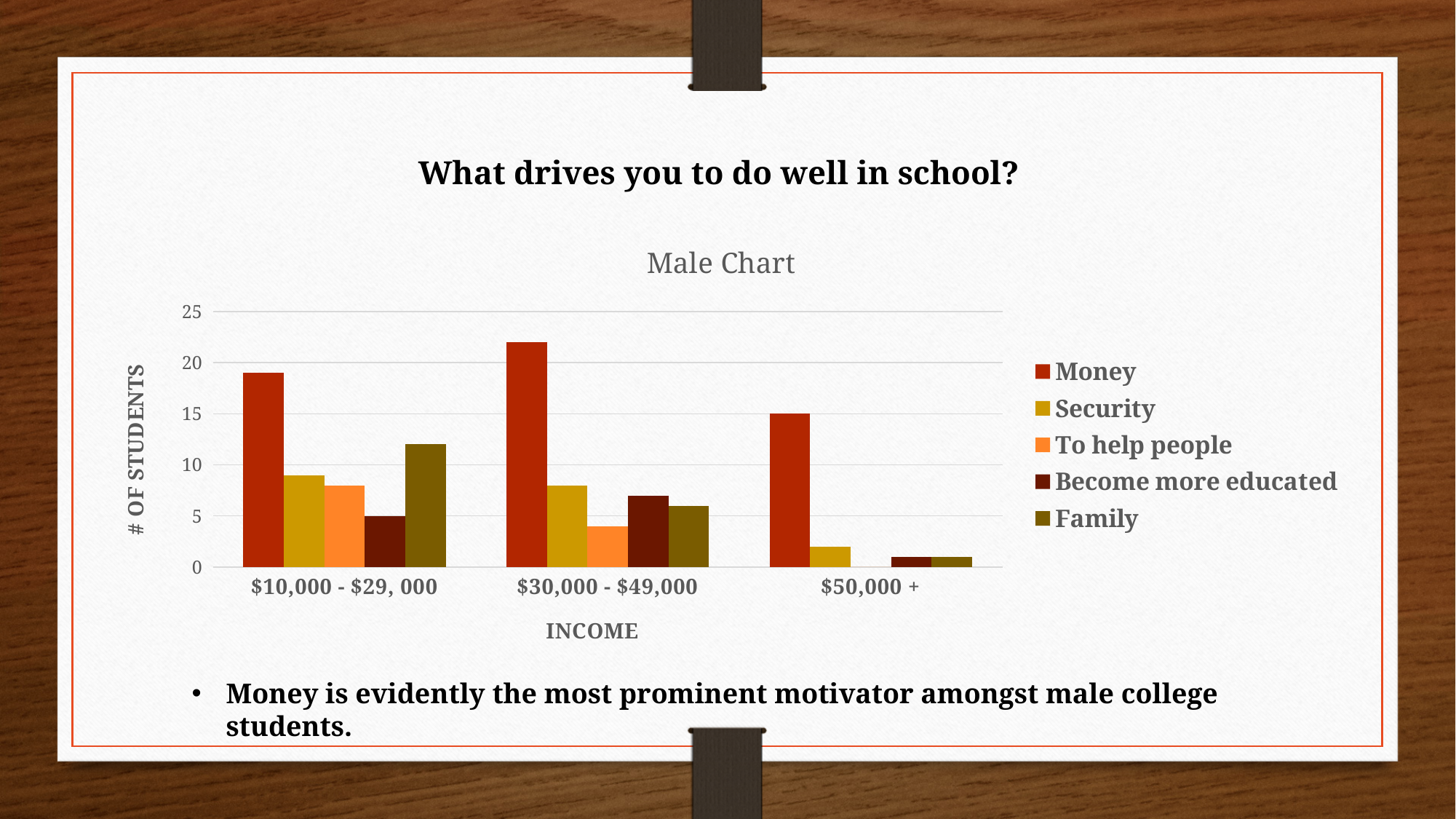
In the $10,000 - $29, 000 category, which is larger: Family or Become more educated? Family Does the value for Security rise or fall across the income categories from left to right? fall What is the title of the chart? Male Chart How many income categories are shown on the x axis? 3 In which income category is the Money bar highest? $30,000 - $49,000 Is the value for Money in the $30,000 - $49,000 category greater or less than 20? greater How many series does the legend list? 5 What is the label of the x axis? INCOME What kind of chart is shown on the slide? bar chart Is the value for Family in the $10,000 - $29, 000 category greater or less than 10? greater Is the value for Security in the $50,000 + category greater or less than 5? less Which series has the lowest value in the $50,000 + category? To help people